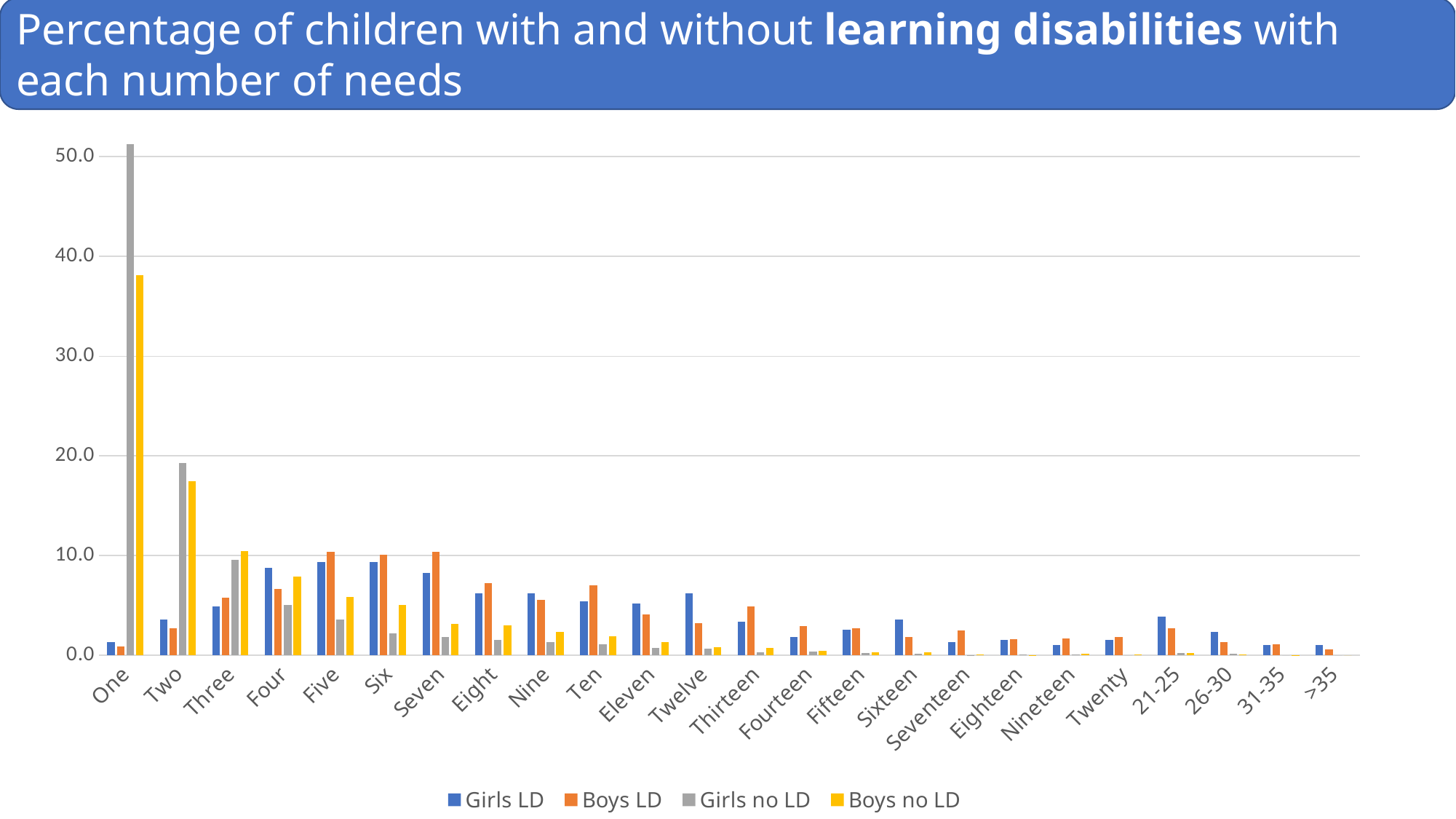
Which is larger at the category Three: Girls LD or Boys no LD? Boys no LD For which category is the Girls no LD value highest? One Do the Girls no LD values rise or fall along the x axis from One to Ten? Fall Which is larger at the category One: Girls no LD or Boys no LD? Girls no LD Is the value for Girls no LD at Two greater or less than 20? less How many categories are shown on the x axis? 24 Is the value for Boys no LD at One greater or less than 30? greater How many series does the legend list? 4 Which series has the highest value for the category One? Girls no LD Is the value for Girls no LD at One greater or less than 40? greater What kind of chart is shown on the slide? Bar chart